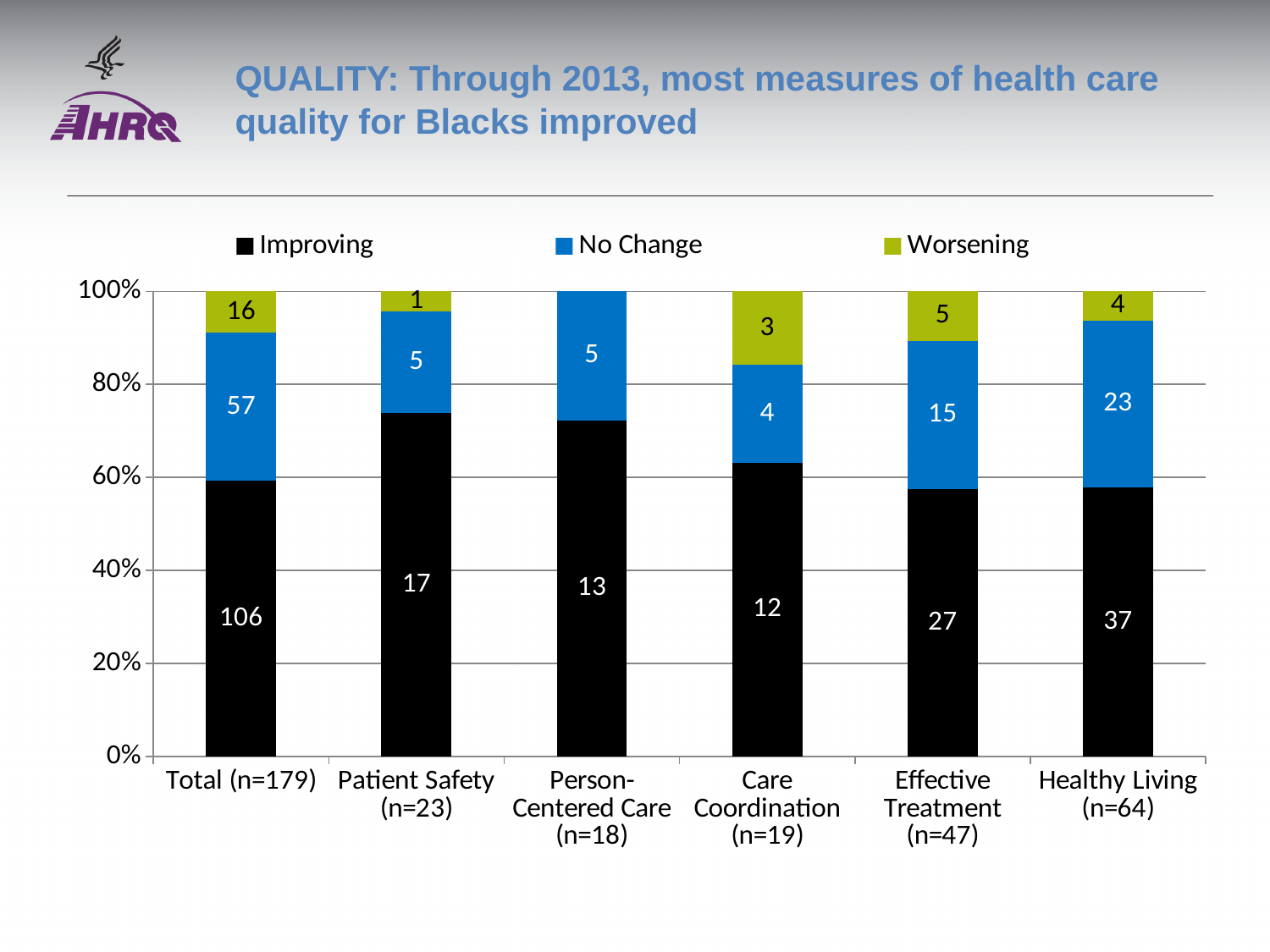
Which category has the highest Worsening value? Total (n=179) What is the difference between the Improving and No Change values for Healthy Living (n=64)? 14 Is the Improving share of the Patient Safety (n=23) bar greater or less than 60%? greater What is the Improving value for Total (n=179)? 106 How many series does the legend list? 3 What is the total of the stacked bar for Patient Safety (n=23)? 23 Which category has the lowest Improving value? Care Coordination (n=19) How many categories are shown on the x axis? 6 What is the No Change value for Healthy Living (n=64)? 23 Which has the larger No Change value, Healthy Living (n=64) or Effective Treatment (n=47)? Healthy Living (n=64) What is the Worsening value for Care Coordination (n=19)? 3 What is the Improving value for Effective Treatment (n=47)? 27